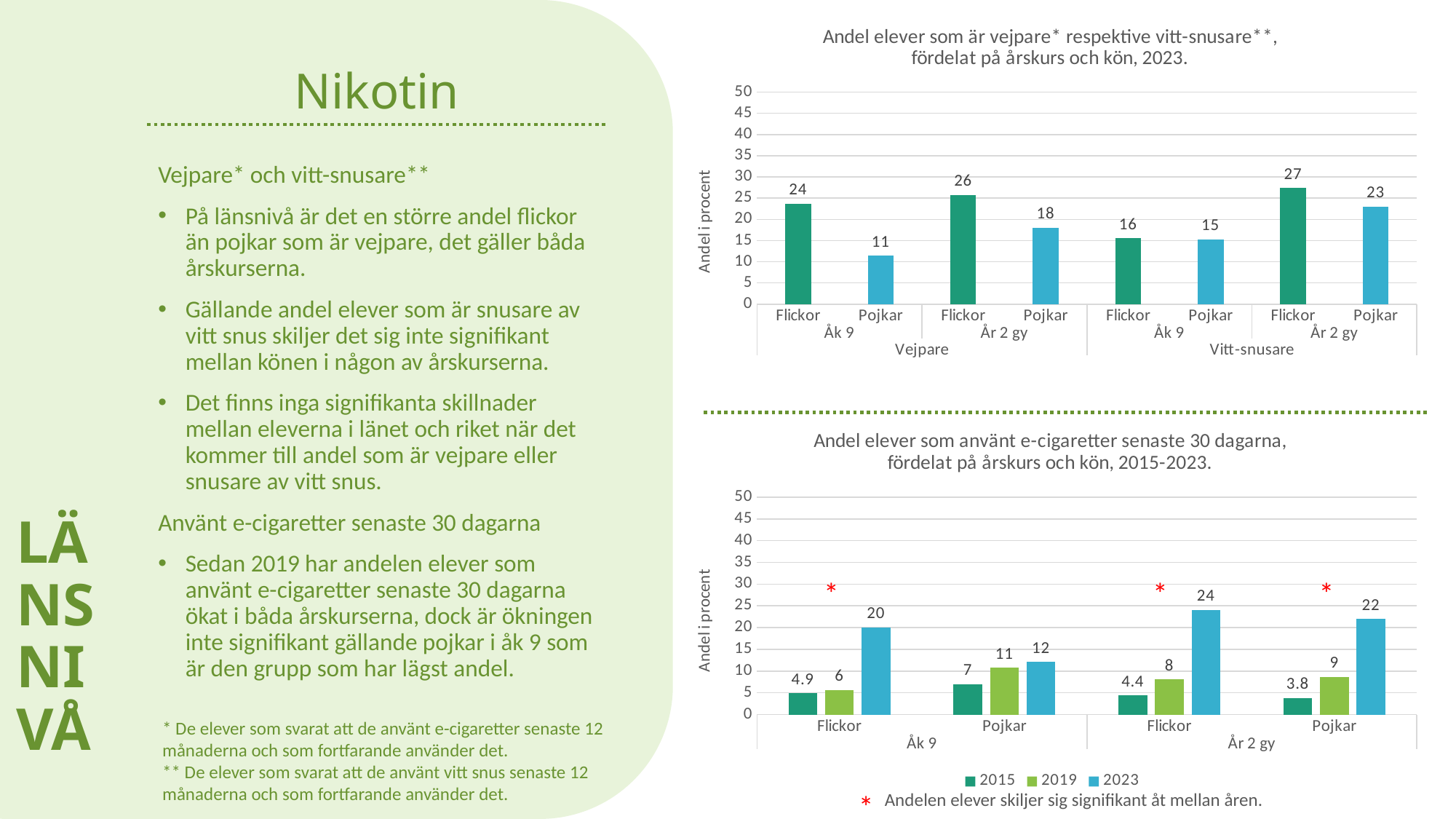
In the bottom chart, what is the 2015 value for Pojkar in År 2 gy? 3.8 In the top chart, which is larger among Vitt-snusare in År 2 gy: Flickor or Pojkar? Flickor In the bottom chart, how many series does the legend list? 3 In the bottom chart, what is the 2023 value for Flickor in År 2 gy? 24 In the top chart, how many bars are plotted? 8 In the top chart, what is the difference between Flickor and Pojkar in Åk 9 among Vejpare? 13 In the top chart, what is the value for Flickor in År 2 gy among Vitt-snusare? 27 In the bottom chart, do the values for Pojkar in Åk 9 rise or fall from 2015 to 2023? rise In the bottom chart, what is the difference between the 2023 and 2015 values for Flickor in Åk 9? 15.1 In the top chart, what is the value for Pojkar in Åk 9 among Vejpare? 11 What kind of chart is the bottom chart? bar chart In the top chart, which bar has the lowest value? Pojkar, Åk 9, Vejpare